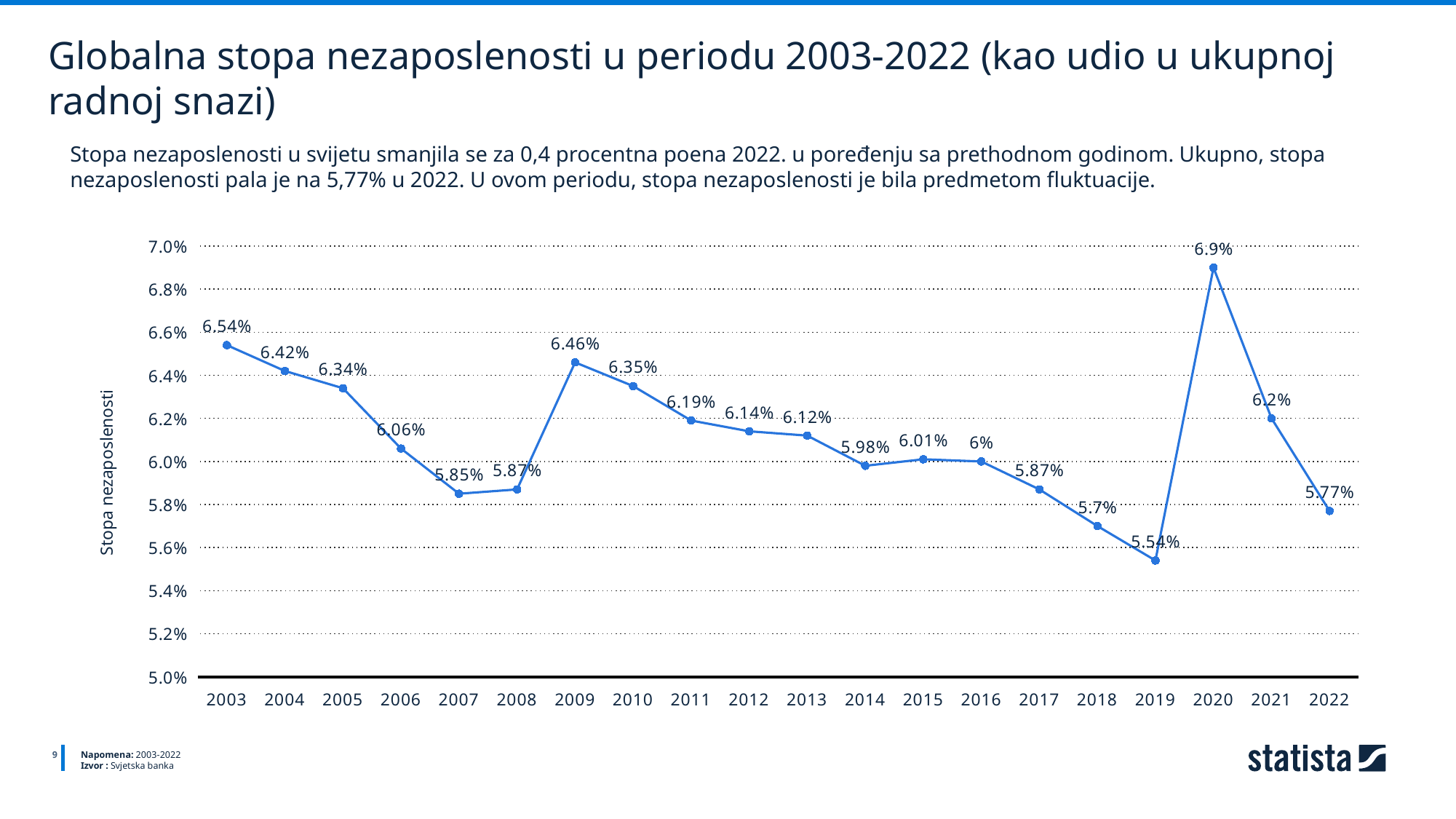
Is the value for 2018 greater or less than 6.0%? less What kind of chart is shown on the slide? line chart What is the difference between the values for 2020 and 2019? 1.36% What is the global unemployment rate shown for 2020? 6.9% What is the unemployment rate shown for 2019? 5.54% What is the value shown for 2022? 5.77% Which year has a higher value, 2009 or 2010? 2009 Which year has the lowest unemployment rate on the chart? 2019 How many years are plotted on the x axis? 20 What is the value plotted for 2003? 6.54% Which year has the highest unemployment rate on the chart? 2020 What is the label of the y axis? Stopa nezaposlenosti